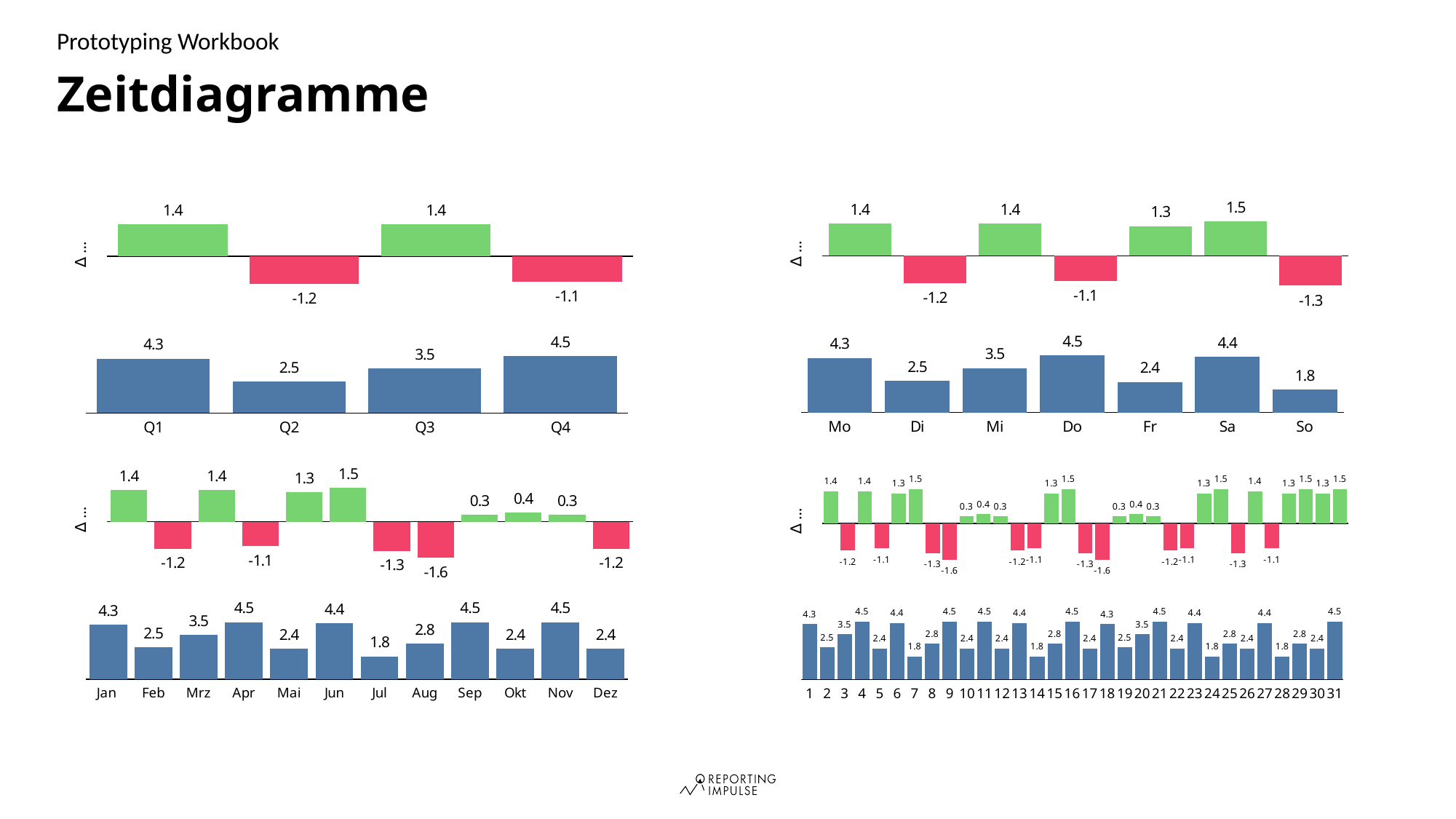
How many categories does the daily bar chart at the bottom right show? 31 In the monthly delta chart at the bottom left, which month has the lowest value? Aug What kind of chart is the monthly chart at the bottom left? Bar chart In the monthly bar chart at the bottom left, which is larger, the value for Mrz or the value for Mai? Mrz In the quarterly delta chart at the top left, what is the value for Q2? -1.2 In the monthly bar chart at the bottom left, what is the value for Aug? 2.8 In the weekday bar chart at the top right, what is the difference between the values for Do and Di? 2.0 In the quarterly bar chart at the top left, which quarter has the highest value? Q4 In the quarterly bar chart at the top left, what is the value for Q3? 3.5 In the weekday delta chart at the top right, what is the value for Sa? 1.5 In the weekday bar chart at the top right, what is the value for Fr? 2.4 In the weekday bar chart at the top right, which day has the lowest value? So